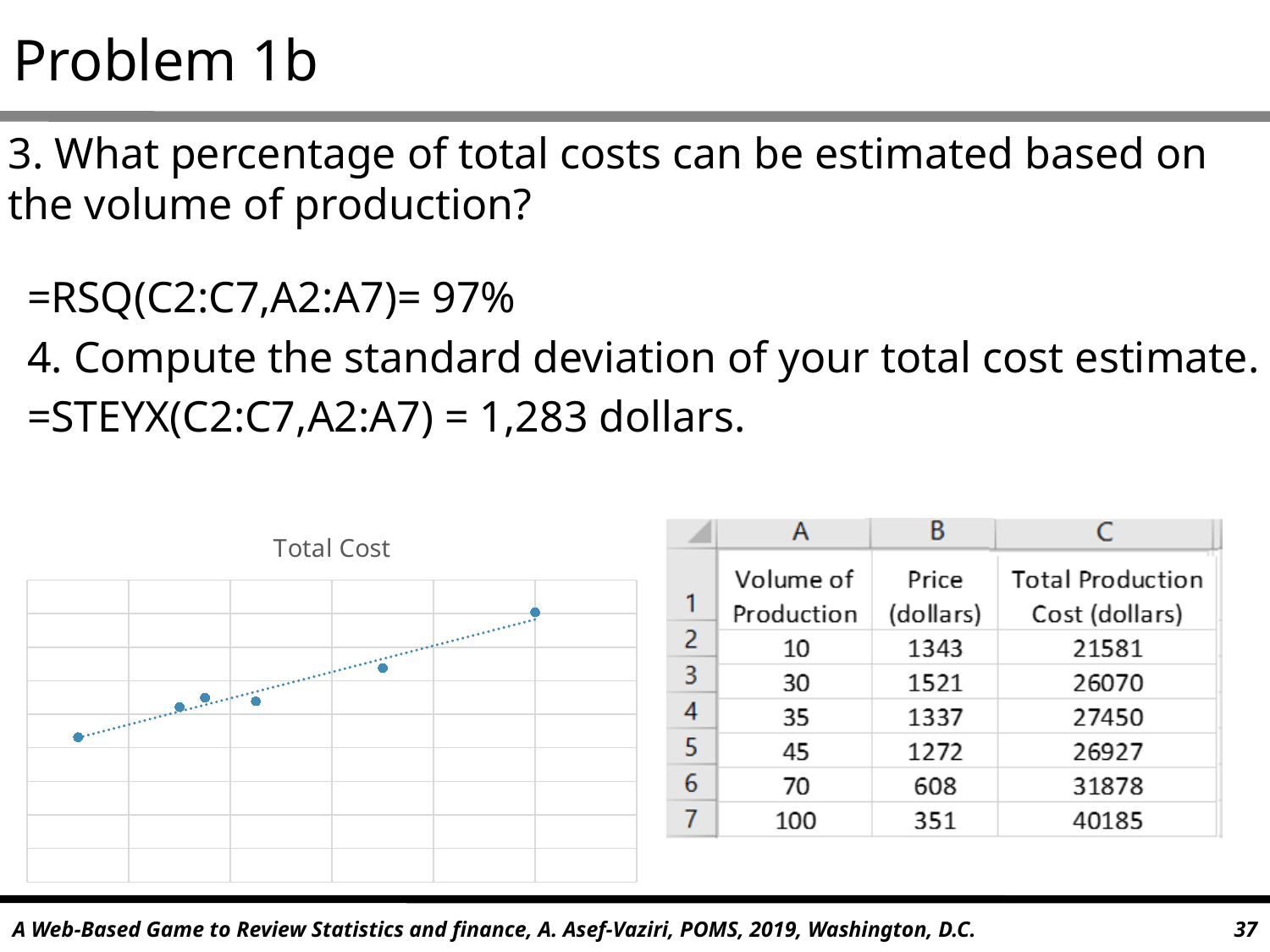
What kind of chart is the "Total Cost" chart? scatter chart Do the plotted values in the "Total Cost" chart generally rise or fall from left to right? rise How many data points are plotted in the "Total Cost" chart? 6 In the "Total Cost" chart, which is higher: the rightmost point or the leftmost point? the rightmost point In the "Total Cost" chart, which is higher: the fifth point from the left or the fourth point from the left? the fifth point Does the "Total Cost" chart show a legend? No What is the title of the chart on the slide? Total Cost In the "Total Cost" chart, is the highest point the leftmost or the rightmost point? rightmost What style of line is drawn through the points in the "Total Cost" chart? a dotted trendline In the "Total Cost" chart, is the lowest point the leftmost or the rightmost point? leftmost